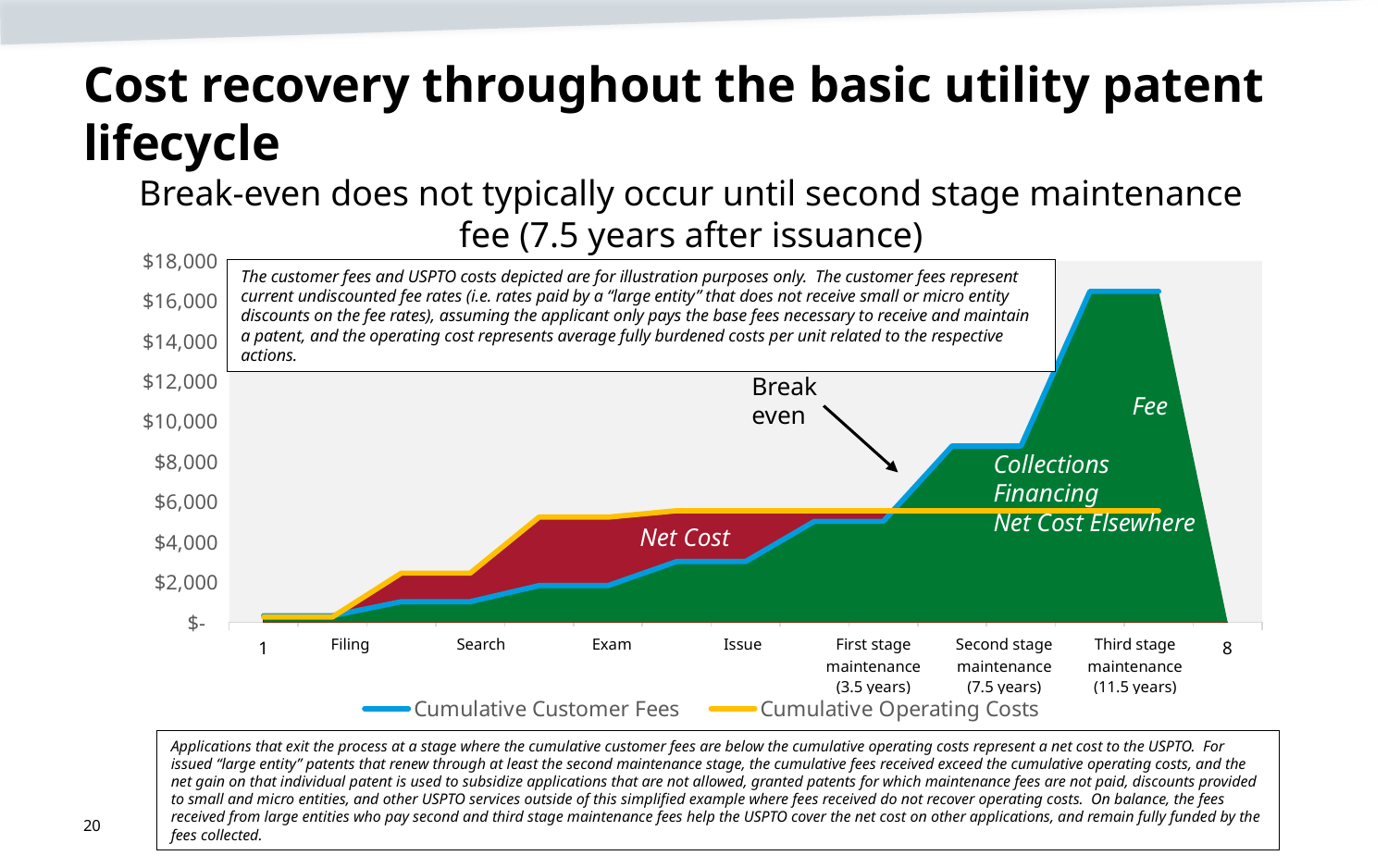
Is the value of Cumulative Customer Fees at Third stage maintenance (11.5 years) greater or less than $14,000? greater What colour is the Cumulative Customer Fees line? Blue Is the value of Cumulative Operating Costs at Third stage maintenance (11.5 years) greater or less than $8,000? less At Third stage maintenance (11.5 years), which series is higher: Cumulative Customer Fees or Cumulative Operating Costs? Cumulative Customer Fees At which labeled stage does Cumulative Customer Fees reach its highest value? Third stage maintenance (11.5 years) What kind of chart is shown on the slide? Combination area and line chart Does the Cumulative Customer Fees line rise or fall from Filing to Third stage maintenance (11.5 years)? Rise At Exam, which series is higher: Cumulative Customer Fees or Cumulative Operating Costs? Cumulative Operating Costs Is the value of Cumulative Customer Fees at Second stage maintenance (7.5 years) greater or less than $6,000? greater What are the two series named in the chart legend? Cumulative Customer Fees and Cumulative Operating Costs How many series does the chart legend list? 2